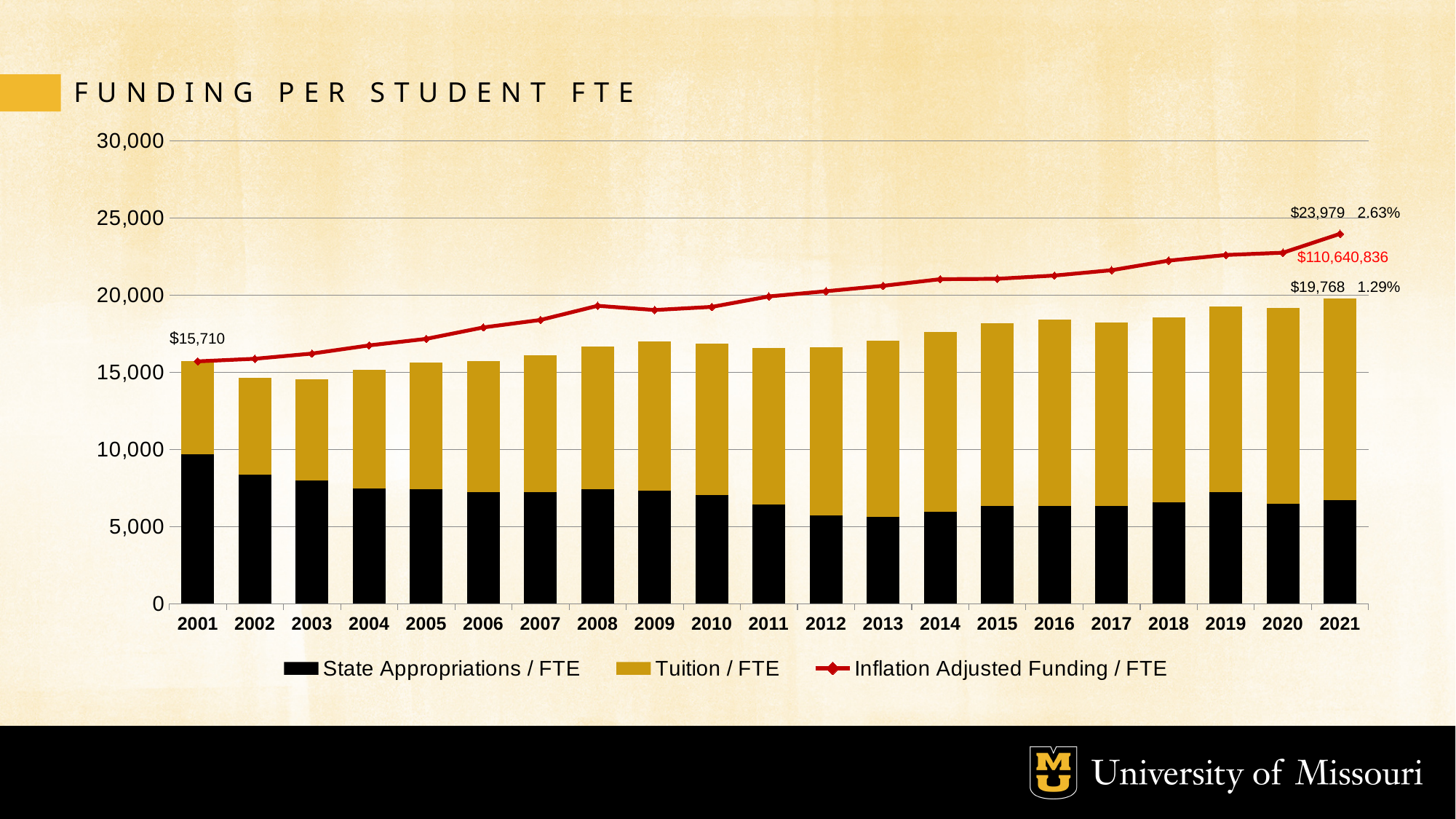
What is the difference between the 2021 Inflation Adjusted Funding / FTE ($23,979) and the 2021 bar total ($19,768)? $4,211 What kind of chart is shown on the slide? A stacked bar chart with a line What is the Inflation Adjusted Funding / FTE value labelled for 2021? $23,979 Is the State Appropriations / FTE value for 2001 greater or less than 5,000? greater What value is labelled at the start of the chart for 2001? $15,710 What is the total funding per student FTE labelled on the 2021 bar? $19,768 Does the Inflation Adjusted Funding / FTE line generally rise or fall from 2001 to 2021? rise How many series does the legend list? 3 Is the Inflation Adjusted Funding / FTE value for 2008 greater or less than 20,000? less How many years are shown on the x axis of the chart? 21 Which year has the larger State Appropriations / FTE value, 2001 or 2021? 2001 Which year has the highest total bar (State Appropriations plus Tuition per FTE)? 2021